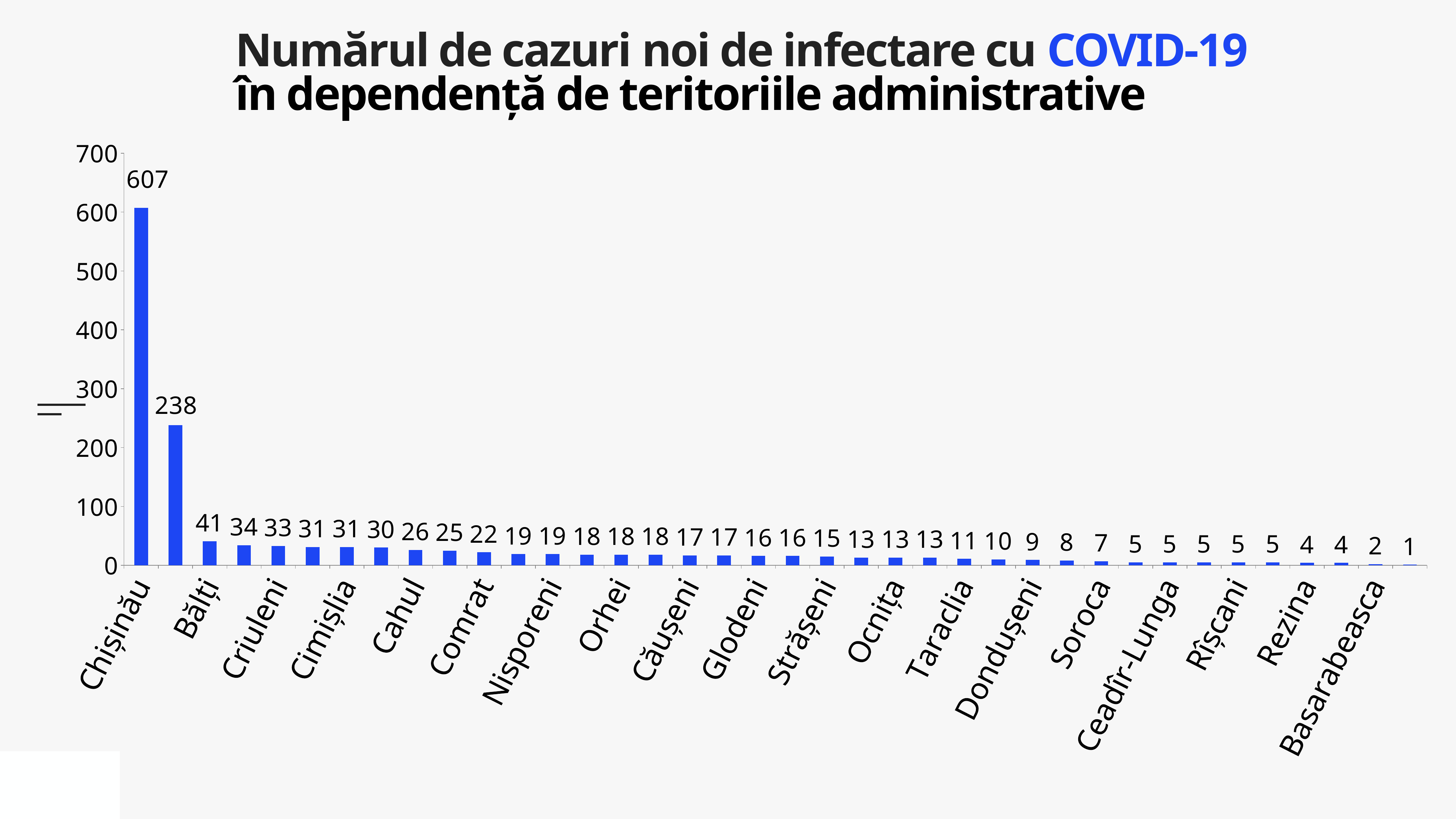
Do the bar values rise or fall from left to right across the chart? fall How many bars have a value above 100? 2 How many new COVID-19 cases are shown for Chișinău? 607 What is the value of the second-highest bar in the chart? 238 What is the difference between the two highest bars (607 and 238)? 369 What is the smallest value shown on any bar in the chart? 1 Is the value for Chișinău greater or less than 600? greater What type of chart is shown on the slide? bar chart What is the highest tick value shown on the vertical axis? 700 Which territory has the highest number of new COVID-19 cases? Chișinău What is the title of the chart? Numărul de cazuri noi de infectare cu COVID-19 în dependență de teritoriile administrative